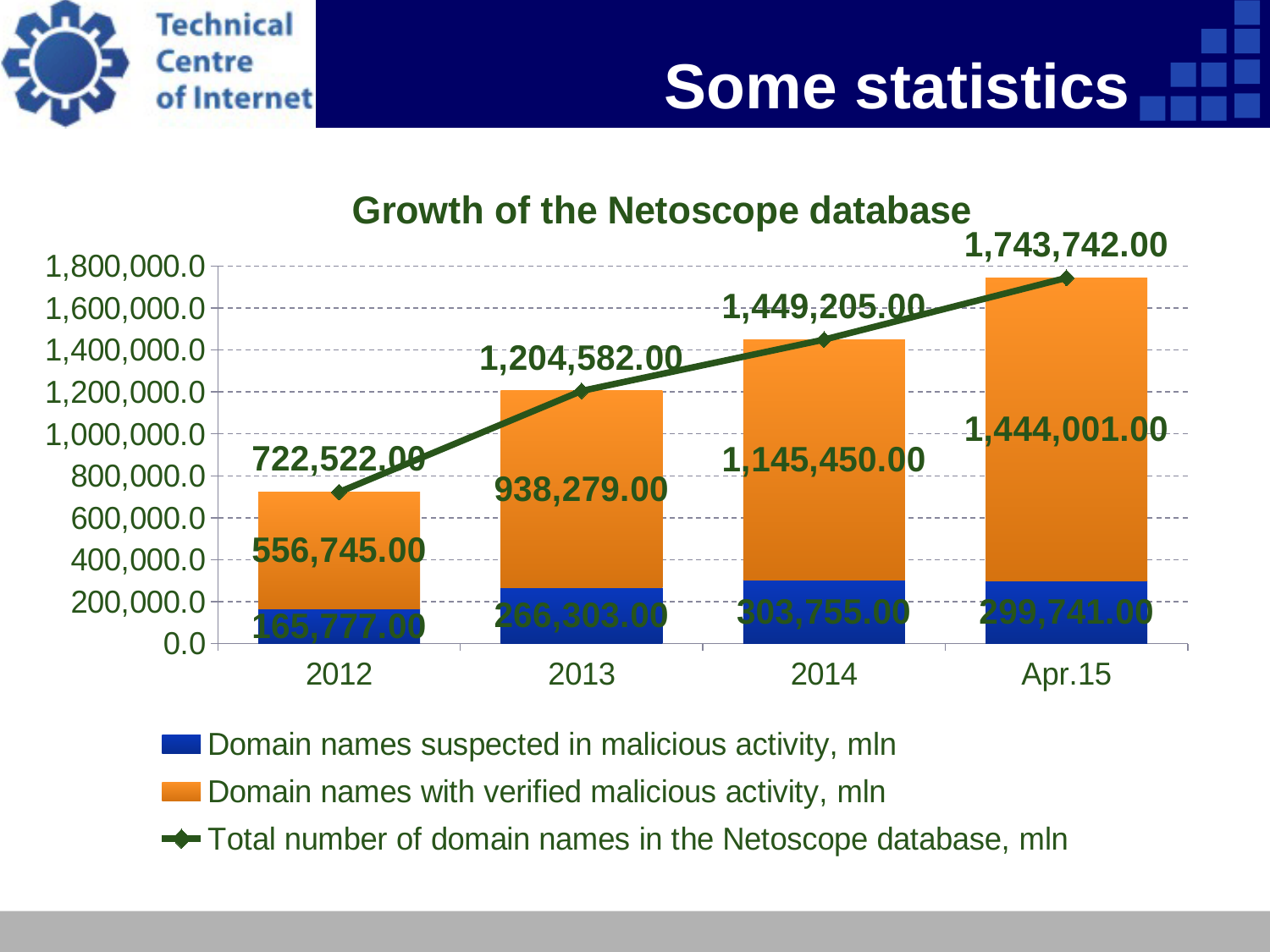
Does the 'Total number of domain names in the Netoscope database' rise or fall from 2012 to Apr.15? Rise Which category has the lowest value for 'Domain names with verified malicious activity'? 2012 What is the 'Total number of domain names in the Netoscope database' for Apr.15? 1,743,742.00 What is the value for 'Domain names suspected in malicious activity' in 2012? 165,777.00 Which is larger: 'Domain names suspected in malicious activity' in 2013 or in 2012? 2013 What is the difference between the 'Total number of domain names in the Netoscope database' in 2014 and in 2013? 244,623.00 What is the title of the chart? Growth of the Netoscope database What kind of chart is shown on the slide? Stacked bar chart with a line How many categories are shown on the x axis? 4 How many series does the legend list? 3 What is the value for 'Domain names with verified malicious activity' in 2013? 938,279.00 Which category has the highest value for 'Domain names suspected in malicious activity'? 2014